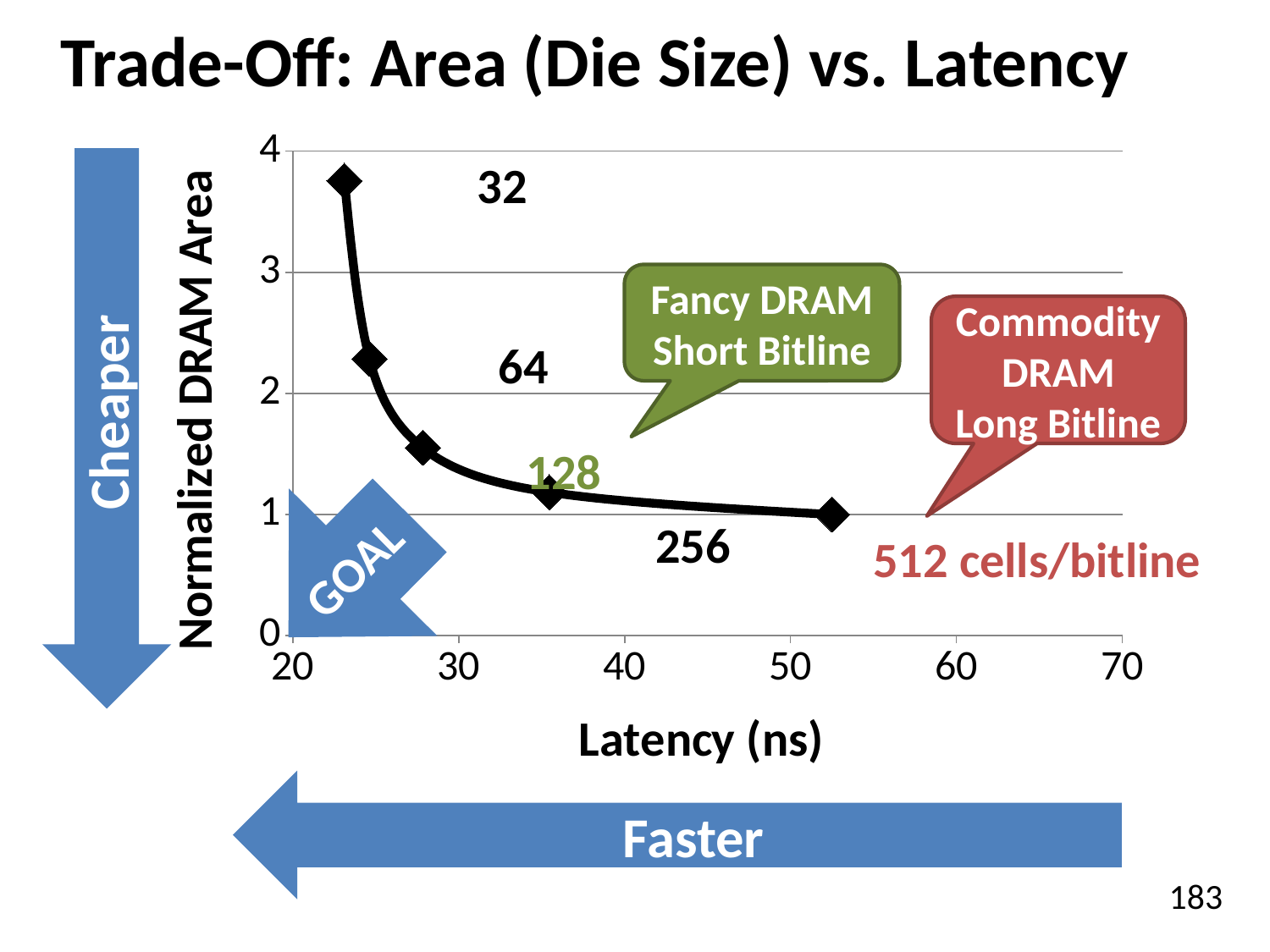
How many data points are plotted on the curve? 5 Is the normalized DRAM area for the 32 cells/bitline point greater or less than 3? greater Is the latency for the 512 cells/bitline point greater or less than 50 ns? greater As latency increases along the x axis, does the normalized DRAM area rise or fall? fall Which cells/bitline configuration has the lowest normalized DRAM area? 512 What is the title of the x axis? Latency (ns) Is the latency for the 32 cells/bitline point greater or less than 30 ns? less What is the title of the y axis? Normalized DRAM Area What kind of chart is shown on the slide? line chart Which cells/bitline configuration has the highest normalized DRAM area? 32 What is the normalized DRAM area for the 512 cells/bitline point? 1